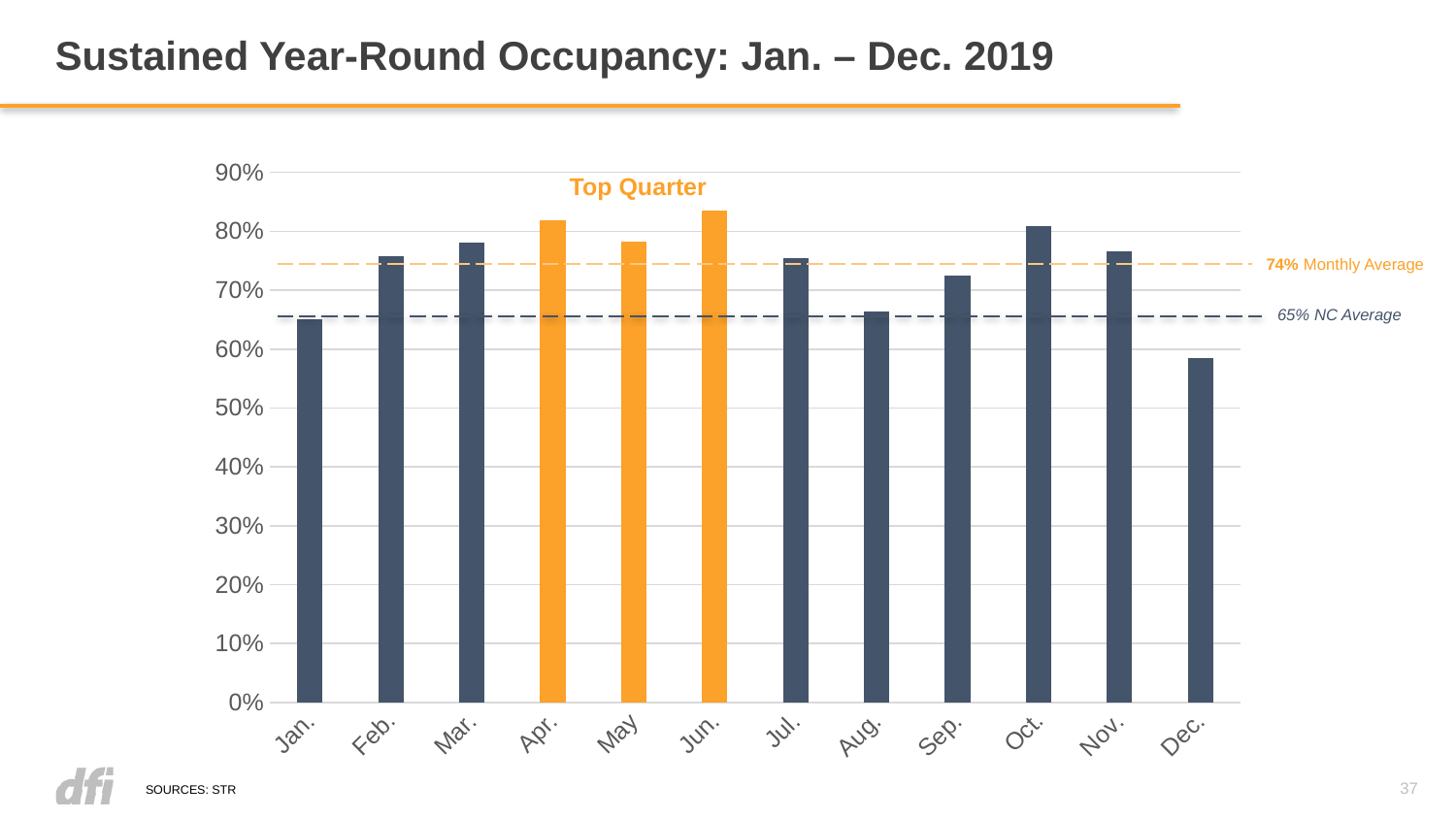
Is the occupancy value for Aug. greater or less than 70%? less Is the occupancy value for Dec. greater or less than 60%? less Is the occupancy value for Sep. greater or less than 80%? less Which months are highlighted in orange as the Top Quarter? Apr., May, Jun. How many months are plotted on the x axis? 12 Which is larger, the occupancy for Oct. or for Sep.? Oct. What monthly average occupancy is marked by the orange dashed line? 74% What kind of chart is shown on the slide? Bar chart Which month has the lowest occupancy? Dec. Which is larger, the occupancy for Mar. or for Dec.? Mar. What NC average occupancy is marked by the dark dashed line? 65%